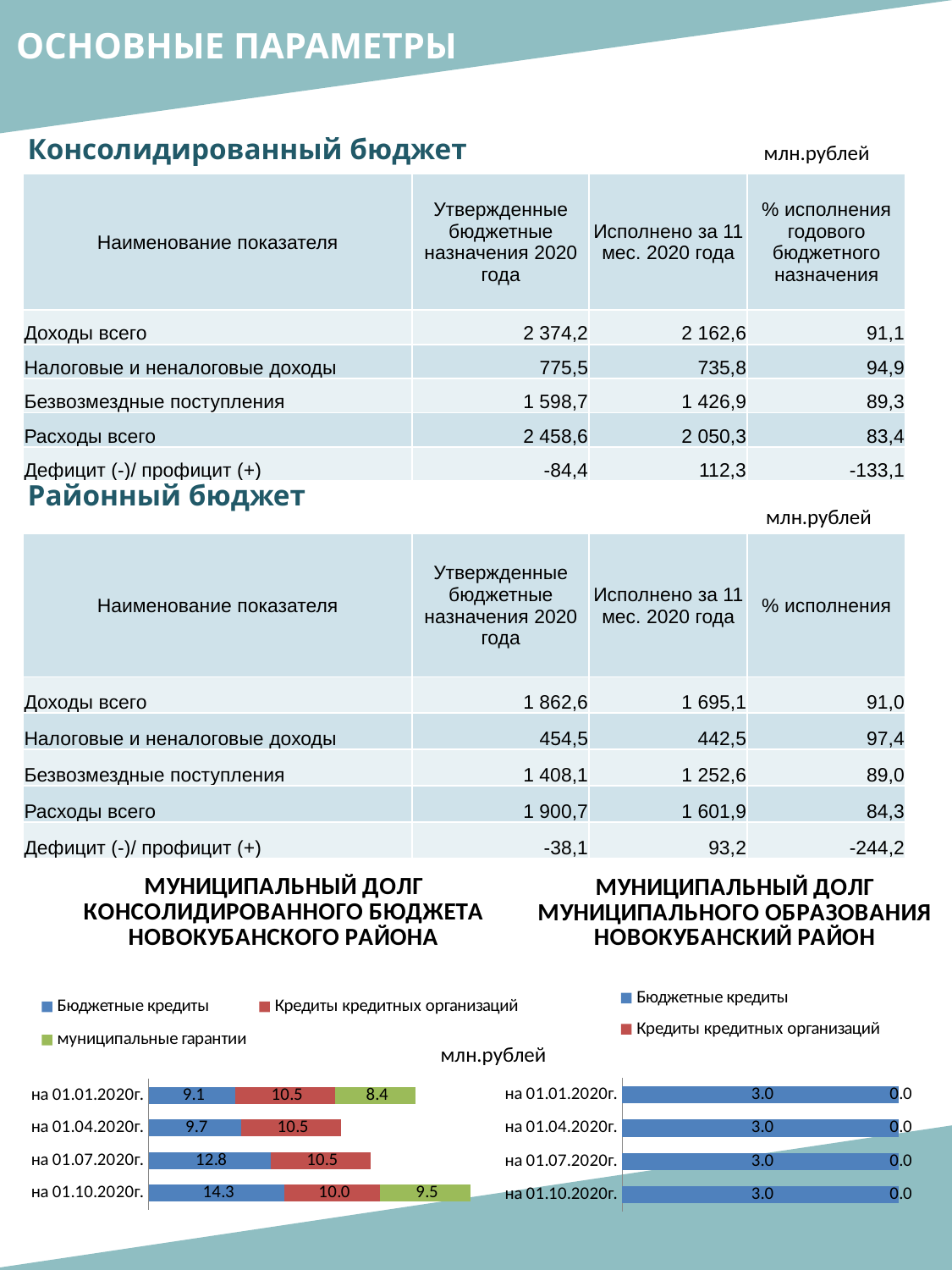
In the chart 'МУНИЦИПАЛЬНЫЙ ДОЛГ КОНСОЛИДИРОВАННОГО БЮДЖЕТА НОВОКУБАНСКОГО РАЙОНА', on which date is 'Бюджетные кредиты' highest? на 01.10.2020г. In the chart 'МУНИЦИПАЛЬНЫЙ ДОЛГ МУНИЦИПАЛЬНОГО ОБРАЗОВАНИЯ НОВОКУБАНСКИЙ РАЙОН', what is the value of 'Бюджетные кредиты' on 01.07.2020? 3.0 In the chart 'МУНИЦИПАЛЬНЫЙ ДОЛГ КОНСОЛИДИРОВАННОГО БЮДЖЕТА НОВОКУБАНСКОГО РАЙОНА', how does 'Бюджетные кредиты' change from 01.01.2020 to 01.10.2020? It rises In the chart 'МУНИЦИПАЛЬНЫЙ ДОЛГ КОНСОЛИДИРОВАННОГО БЮДЖЕТА НОВОКУБАНСКОГО РАЙОНА', what is the difference between 'Бюджетные кредиты' on 01.10.2020 and on 01.01.2020? 5.2 In the chart 'МУНИЦИПАЛЬНЫЙ ДОЛГ КОНСОЛИДИРОВАННОГО БЮДЖЕТА НОВОКУБАНСКОГО РАЙОНА', what is the total of the stacked bar for 01.01.2020? 28.0 In the chart 'МУНИЦИПАЛЬНЫЙ ДОЛГ КОНСОЛИДИРОВАННОГО БЮДЖЕТА НОВОКУБАНСКОГО РАЙОНА', on which date is 'Бюджетные кредиты' lowest? на 01.01.2020г. How many series does the legend of the chart 'МУНИЦИПАЛЬНЫЙ ДОЛГ КОНСОЛИДИРОВАННОГО БЮДЖЕТА НОВОКУБАНСКОГО РАЙОНА' list? 3 In the chart 'МУНИЦИПАЛЬНЫЙ ДОЛГ КОНСОЛИДИРОВАННОГО БЮДЖЕТА НОВОКУБАНСКОГО РАЙОНА', what is the total of the stacked bar for 01.10.2020? 33.8 In the chart 'МУНИЦИПАЛЬНЫЙ ДОЛГ КОНСОЛИДИРОВАННОГО БЮДЖЕТА НОВОКУБАНСКОГО РАЙОНА', what is the value of 'Кредиты кредитных организаций' on 01.10.2020? 10.0 In the chart 'МУНИЦИПАЛЬНЫЙ ДОЛГ КОНСОЛИДИРОВАННОГО БЮДЖЕТА НОВОКУБАНСКОГО РАЙОНА', what is the value of 'Бюджетные кредиты' on 01.10.2020? 14.3 What kind of chart is 'МУНИЦИПАЛЬНЫЙ ДОЛГ МУНИЦИПАЛЬНОГО ОБРАЗОВАНИЯ НОВОКУБАНСКИЙ РАЙОН'? Bar chart In the chart 'МУНИЦИПАЛЬНЫЙ ДОЛГ КОНСОЛИДИРОВАННОГО БЮДЖЕТА НОВОКУБАНСКОГО РАЙОНА', what is the value of 'муниципальные гарантии' on 01.01.2020? 8.4